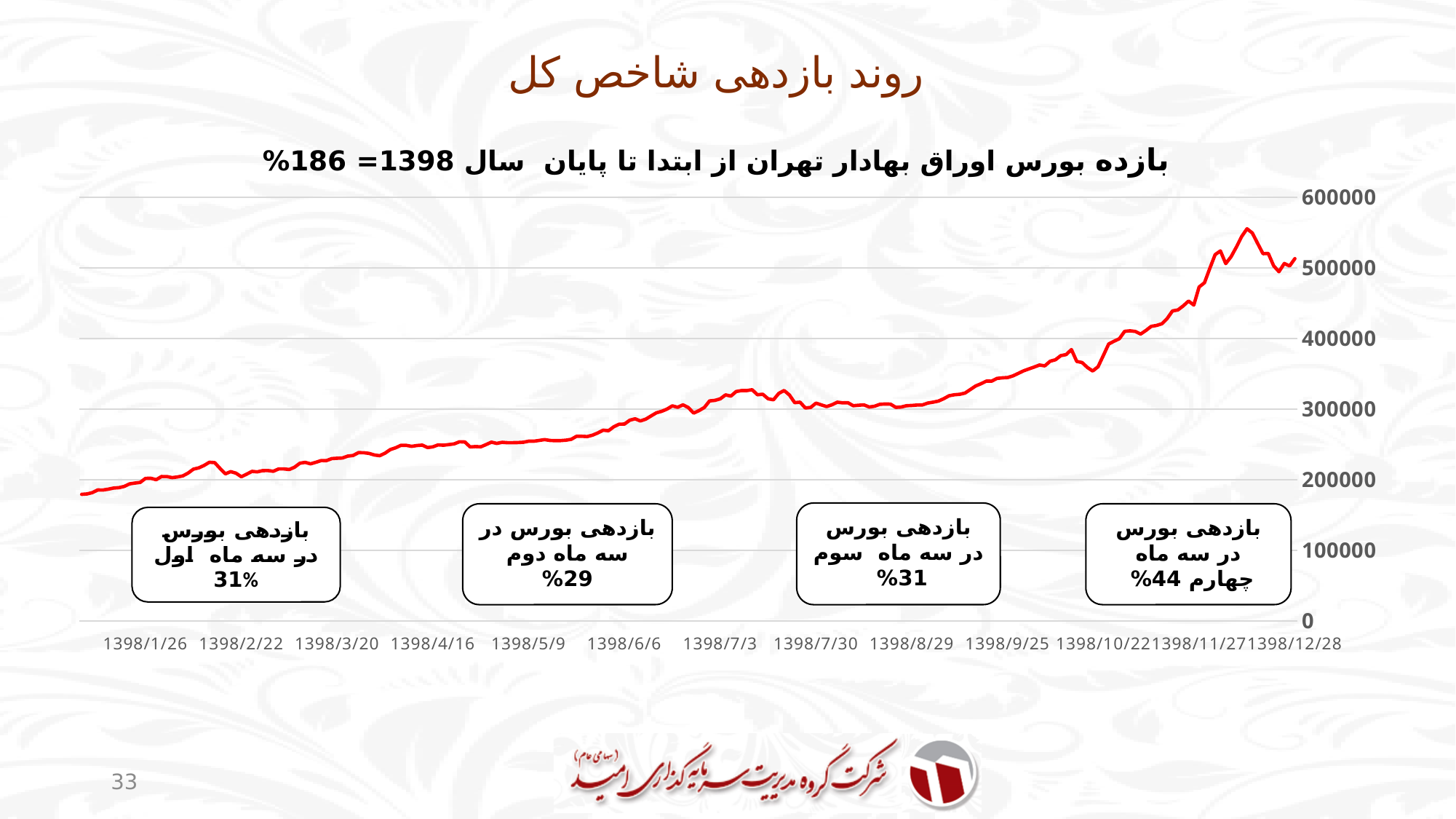
Does the index value generally rise or fall from 1398/1/26 to 1398/12/28? rise What total return for the year 1398 is stated in the chart's subtitle? 186% According to the callout box, what was the stock market return in the fourth three months (سه ماه چهارم)? 44% What is the difference between the fourth-quarter return (44%) and the second-quarter return (29%)? 15% Is the index value at 1398/7/3 greater or less than 300000? greater According to the callout box, what was the stock market return in the second three months (سه ماه دوم)? 29% Which quarter had the highest stock market return according to the callout boxes? سه ماه چهارم (fourth quarter), 44% What kind of chart is shown on the slide? line chart According to the callout box, what was the stock market return in the first three months (سه ماه اول)? 31% Is the highest point of the line greater or less than 500000? greater Is the index value at 1398/6/6 greater or less than 300000? less